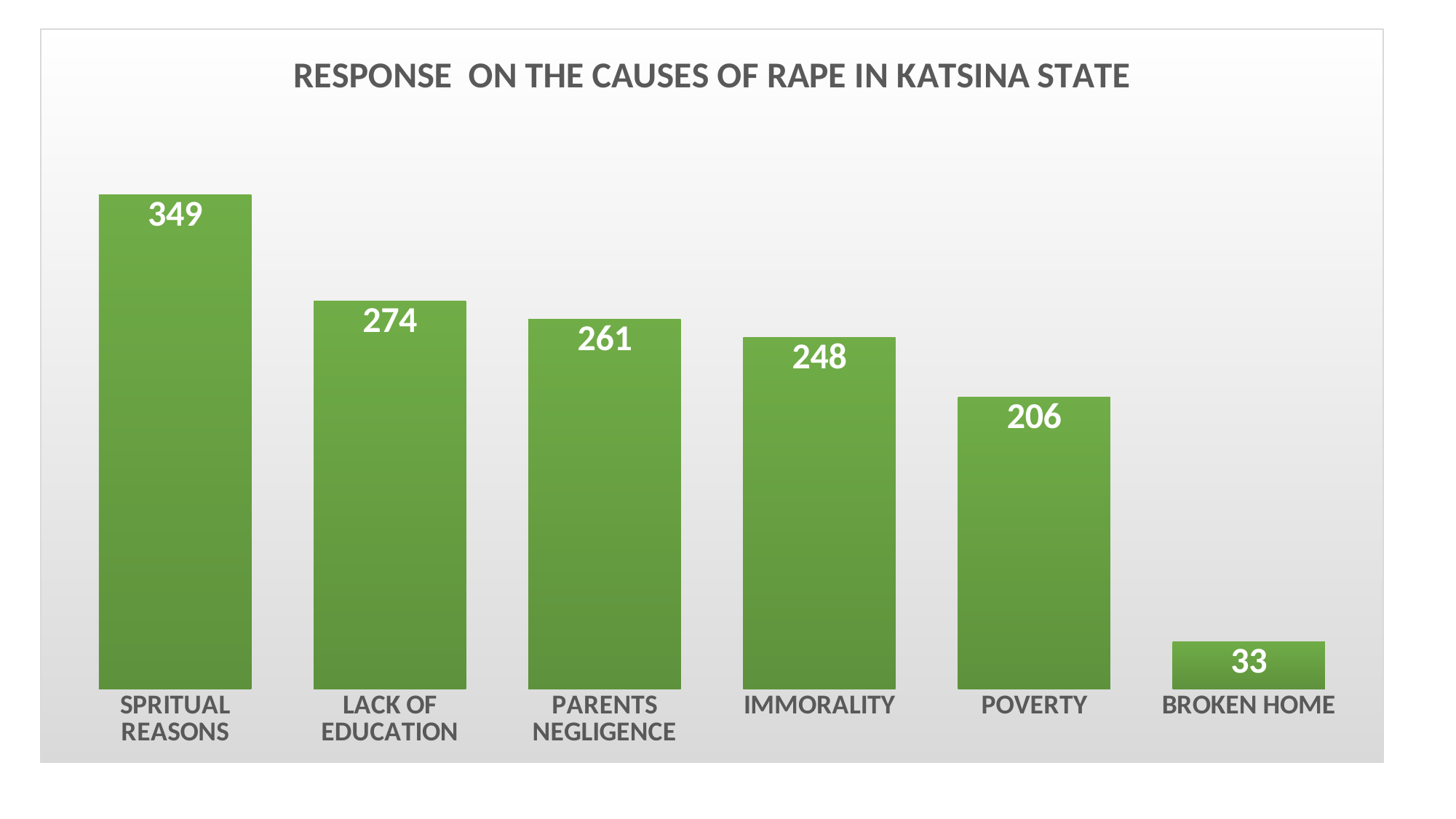
Which category has the lowest value? BROKEN HOME What is the value for SPRITUAL REASONS? 349 How many categories are shown in the chart? 6 What is the value for LACK OF EDUCATION? 274 What is the value for BROKEN HOME? 33 Which is larger, the value for IMMORALITY or the value for POVERTY? IMMORALITY What is the difference between the values for SPRITUAL REASONS and LACK OF EDUCATION? 75 What kind of chart is shown on the slide? Bar chart What is the title of the chart? RESPONSE ON THE CAUSES OF RAPE IN KATSINA STATE Which category has the highest value? SPRITUAL REASONS What is the value for POVERTY? 206 What is the difference between the values for PARENTS NEGLIGENCE and IMMORALITY? 13